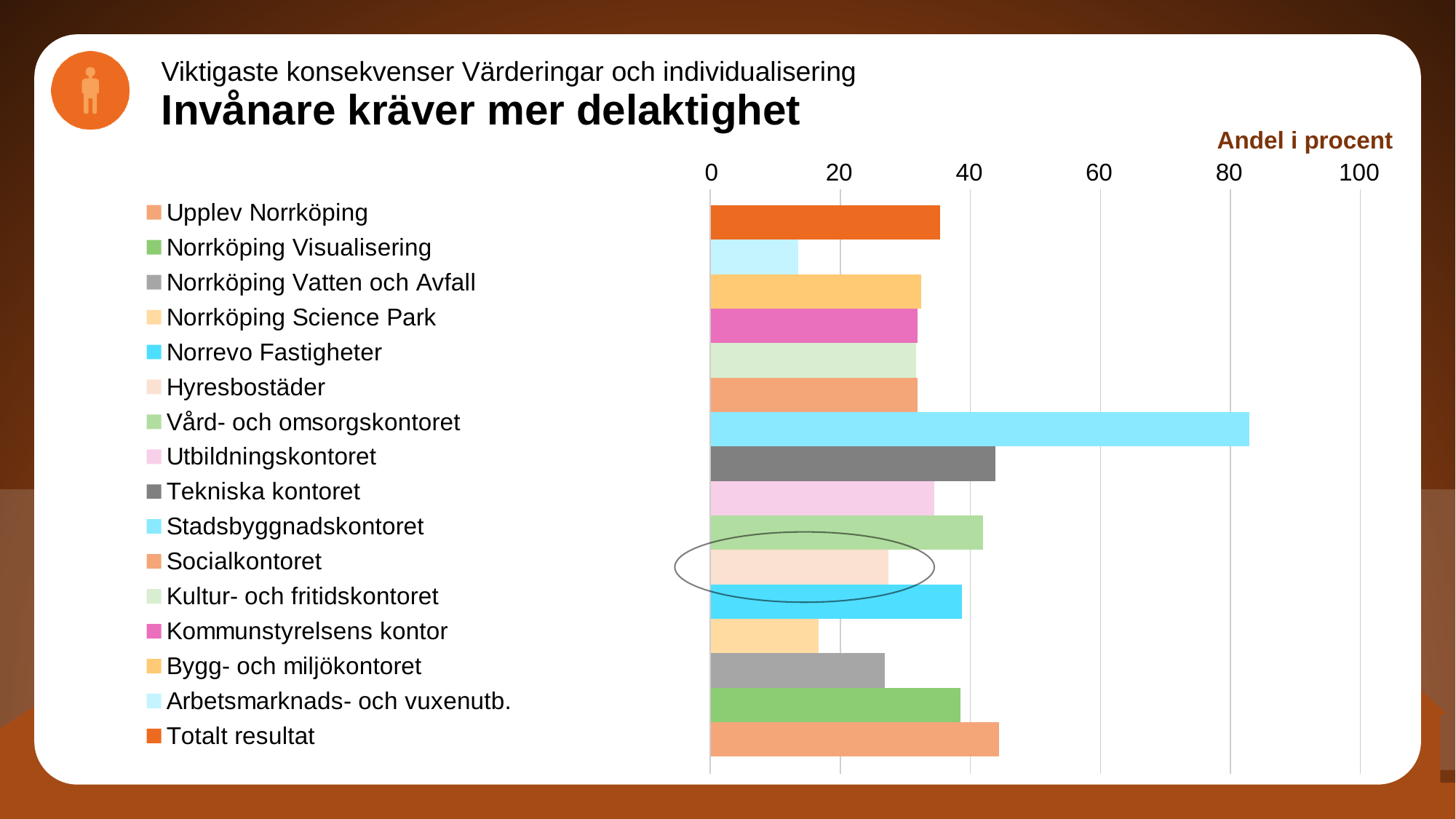
Is the value for Stadsbyggnadskontoret greater or less than 80? greater Which category has the lowest value in the chart? Arbetsmarknads- och vuxenutb. What label is shown above the horizontal axis of the chart? Andel i procent Is the value for Totalt resultat greater or less than 40? less Is the value for Hyresbostäder greater or less than 20? greater Which category has the highest value in the chart? Stadsbyggnadskontoret How many bars are plotted in the chart? 16 How many entries does the chart legend list? 16 Which is larger, the value for Tekniska kontoret or the value for Hyresbostäder? Tekniska kontoret What kind of chart is shown on the slide? bar chart